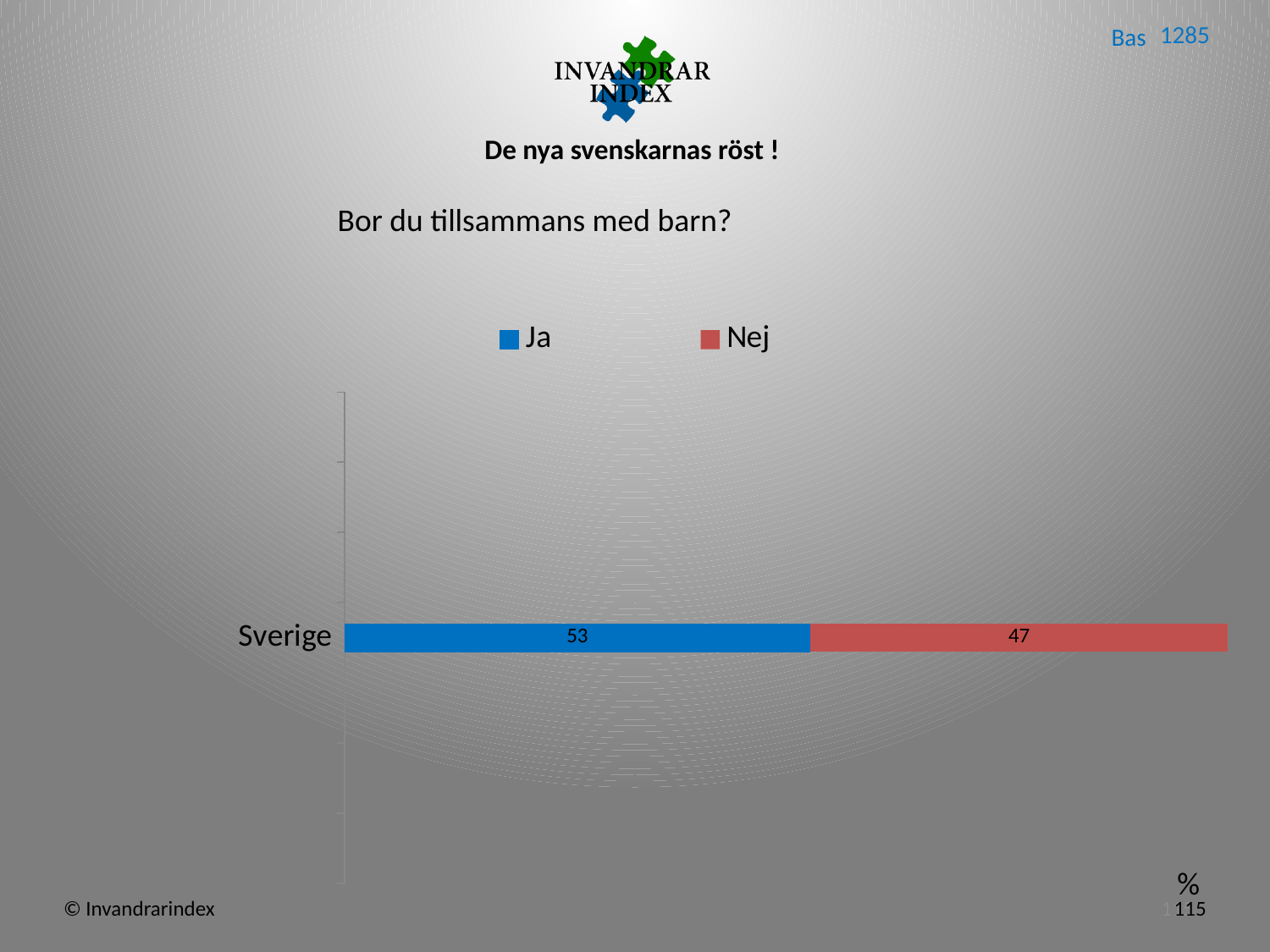
What is the question shown above the chart? Bor du tillsammans med barn? What is the difference between the Ja and Nej values for Sverige? 6 What is the name of the only category on the chart? Sverige What is the value for Ja for Sverige? 53 What is the total of the stacked bar for Sverige? 100 How many categories are plotted on the chart? 1 What kind of chart is shown on the slide? Stacked bar chart What is the value for Nej for Sverige? 47 Which series has the larger value for Sverige, Ja or Nej? Ja How many series does the legend list? 2 Which colour represents Nej in the legend? Red